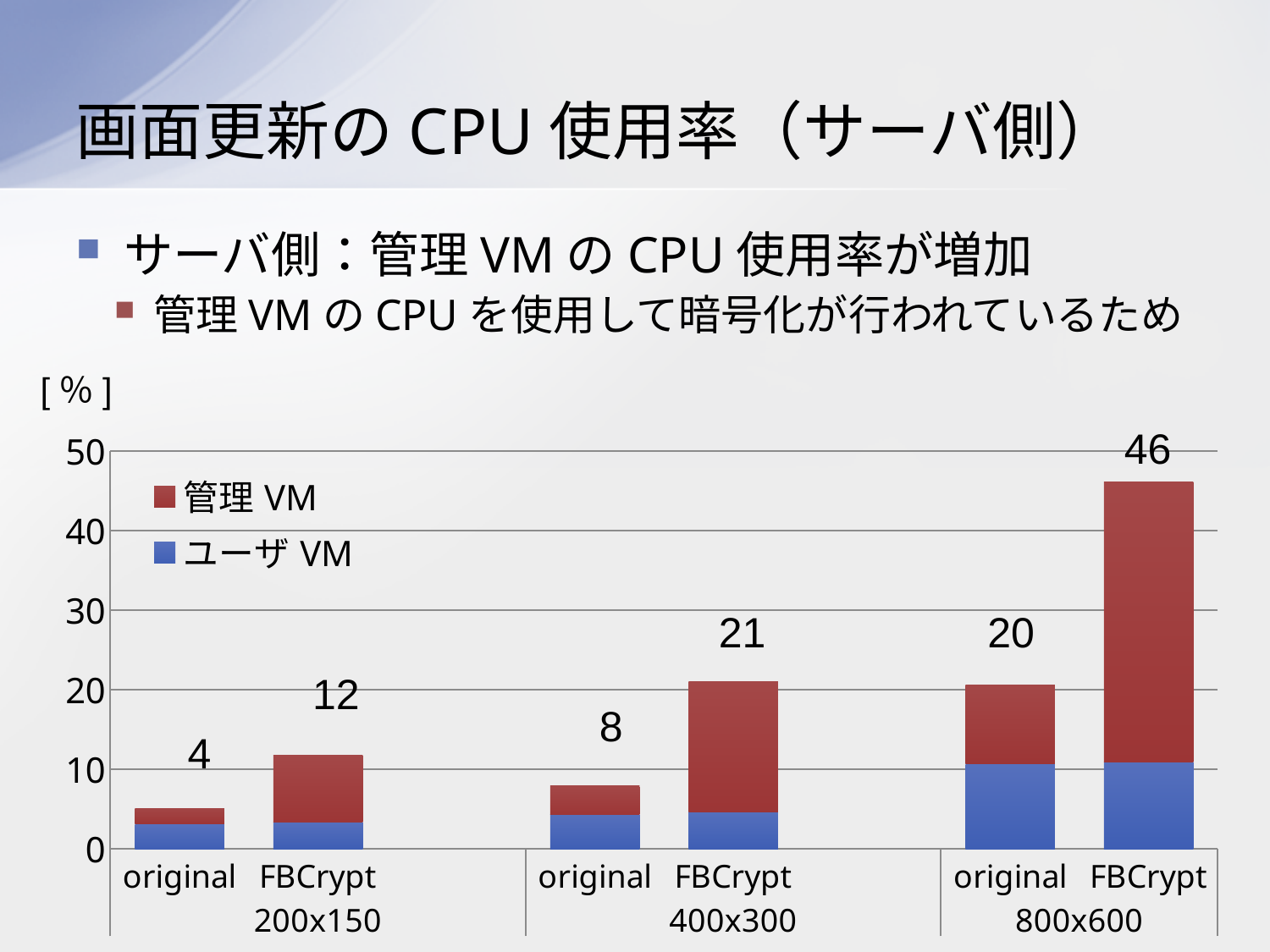
What is the total CPU usage labeled for the original bar at 400x300? 8 Which is larger, the labeled total for FBCrypt at 400x300 or the labeled total for original at 800x600? FBCrypt at 400x300 What unit is shown on the y axis of the chart? [%] How many bars are plotted in the chart? 6 Which bar has the highest total CPU usage? FBCrypt at 800x600 How many series does the legend list? 2 What is the total CPU usage labeled for the FBCrypt bar at 200x150? 12 Which bar has the lowest total CPU usage? original at 200x150 What is the total CPU usage labeled for the FBCrypt bar at 800x600? 46 What is the difference between the labeled totals of FBCrypt and original at 800x600? 26 Is the ユーザ VM portion of the original bar at 200x150 greater or less than 10? less What kind of chart is shown on the slide? stacked bar chart